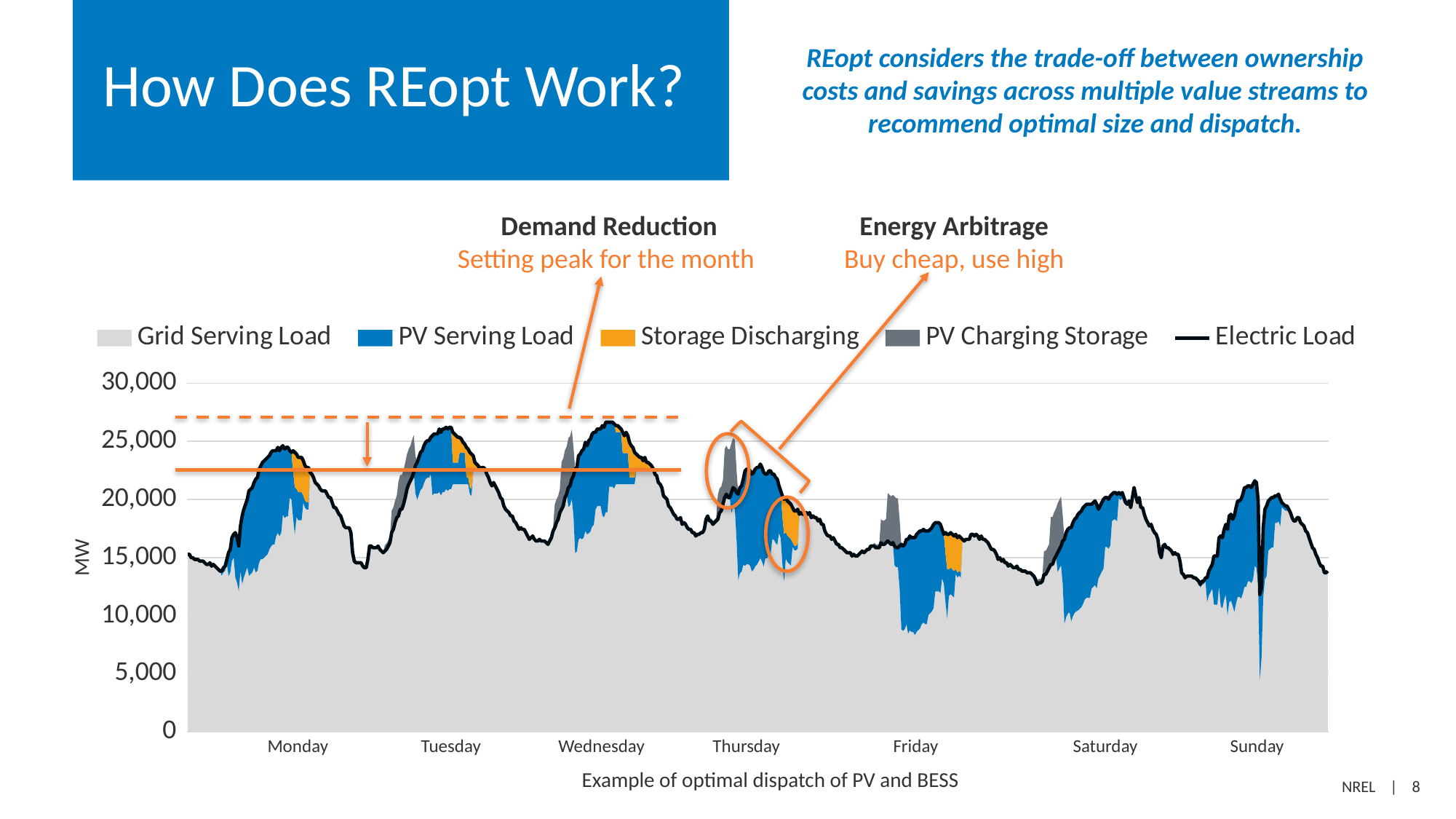
How many series does the chart's legend list? 5 Does the daily peak Electric Load rise or fall from Wednesday to Friday? fall Which legend entry is drawn in orange? Storage Discharging What kind of chart is shown on the slide? Area chart with a line overlay Is the peak Electric Load on Wednesday greater or less than 25,000? greater Is the peak Electric Load on Monday greater or less than 20,000? greater Is the peak Electric Load higher on Wednesday or on Friday? Wednesday Which day shows the lowest Electric Load value on the chart? Sunday Is the lowest Electric Load value on Sunday greater or less than 10,000? less How many days are labelled along the x axis of the chart? 7 What unit is shown on the y axis of the chart? MW